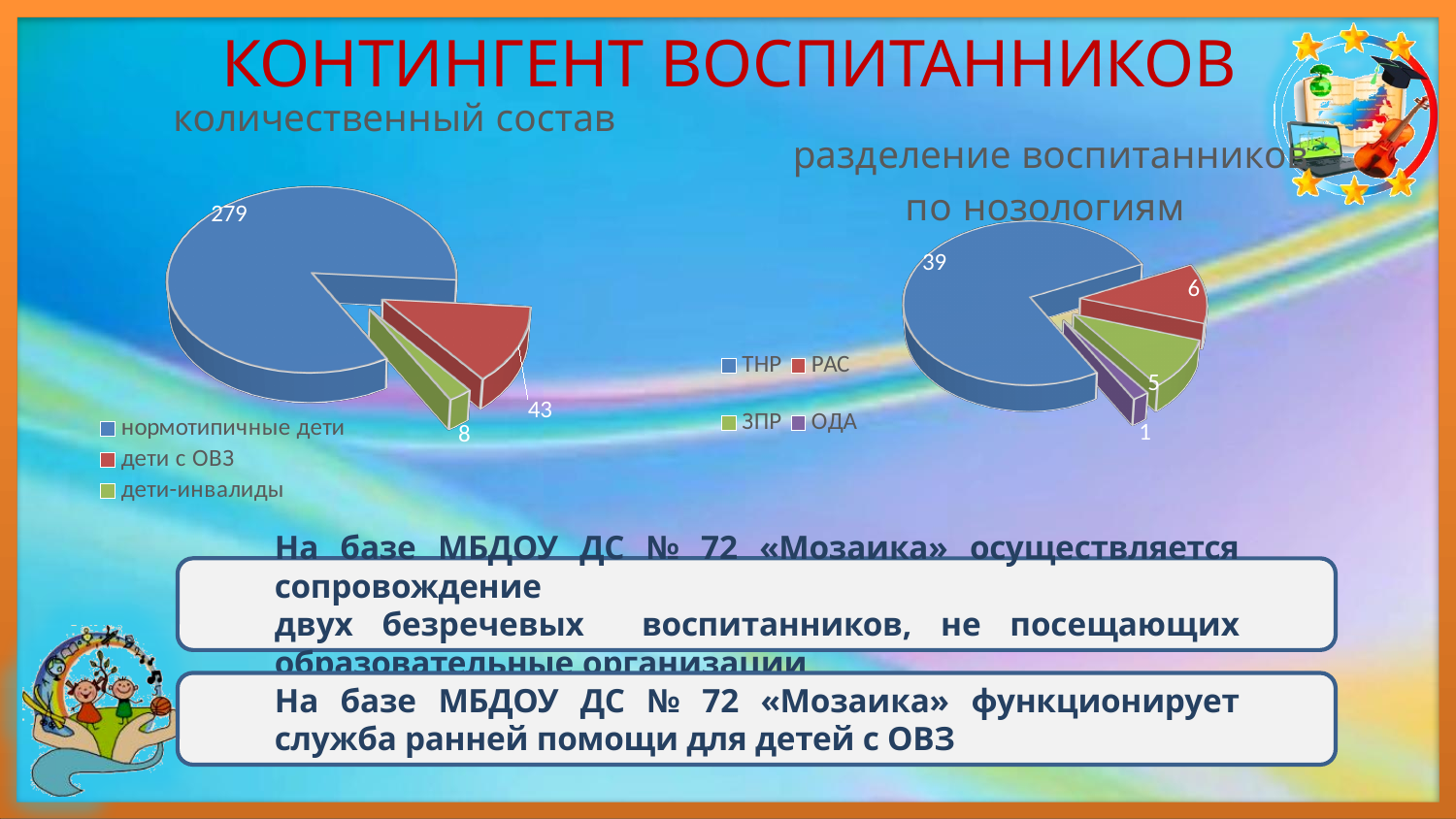
In the right pie chart (разделение воспитанников по нозологиям), what is the value for ТНР? 39 In the right pie chart (разделение воспитанников по нозологиям), which category has the smallest value? ОДА In the left pie chart (количественный состав), what is the value for дети-инвалиды? 8 In the left pie chart (количественный состав), what is the difference between нормотипичные дети and дети с ОВЗ? 236 In the right pie chart (разделение воспитанников по нозологиям), which is larger, РАС or ЗПР? РАС In the left pie chart (количественный состав), which category has the largest value? нормотипичные дети How many categories does the right pie chart (разделение воспитанников по нозологиям) show? 4 In the left pie chart (количественный состав), what is the value for дети с ОВЗ? 43 In the left pie chart (количественный состав), what is the value for нормотипичные дети? 279 What type of chart is used for количественный состав? pie chart How many entries does the legend of the left chart (количественный состав) list? 3 In the right pie chart (разделение воспитанников по нозологиям), what is the value for ОДА? 1